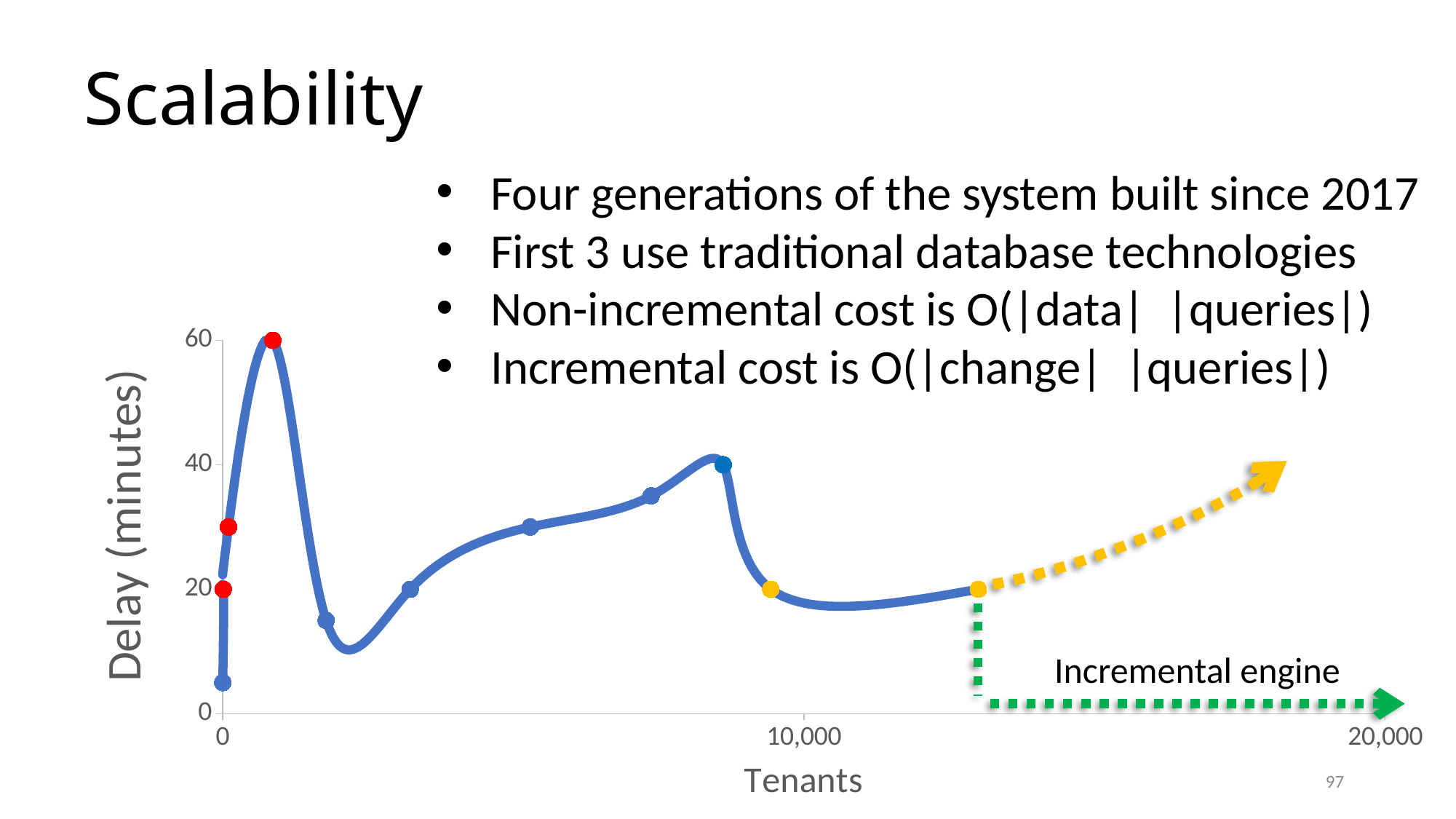
Just after the blue point near 10,000 tenants, does the delay rise or fall as tenants increase? fall What kind of chart is shown on the slide? line chart What is the label of the x axis of the chart? Tenants What is the label of the y axis of the chart? Delay (minutes) Between the dip after the peak and the blue point near 10,000 tenants, does the delay rise or fall? rise Which is higher: the red point at the peak of the curve or the blue point just before 10,000 tenants? the red point at the peak What delay value does the highest point on the curve reach? 60 Is the lowest point of the curve, in the dip after the peak, greater or less than 20? less Is the delay at the first yellow point greater or less than 40? less What is the largest tenant count shown on the x axis? 20,000 Is the peak delay value on the curve greater or less than 40? greater What is the highest value shown on the y axis? 60